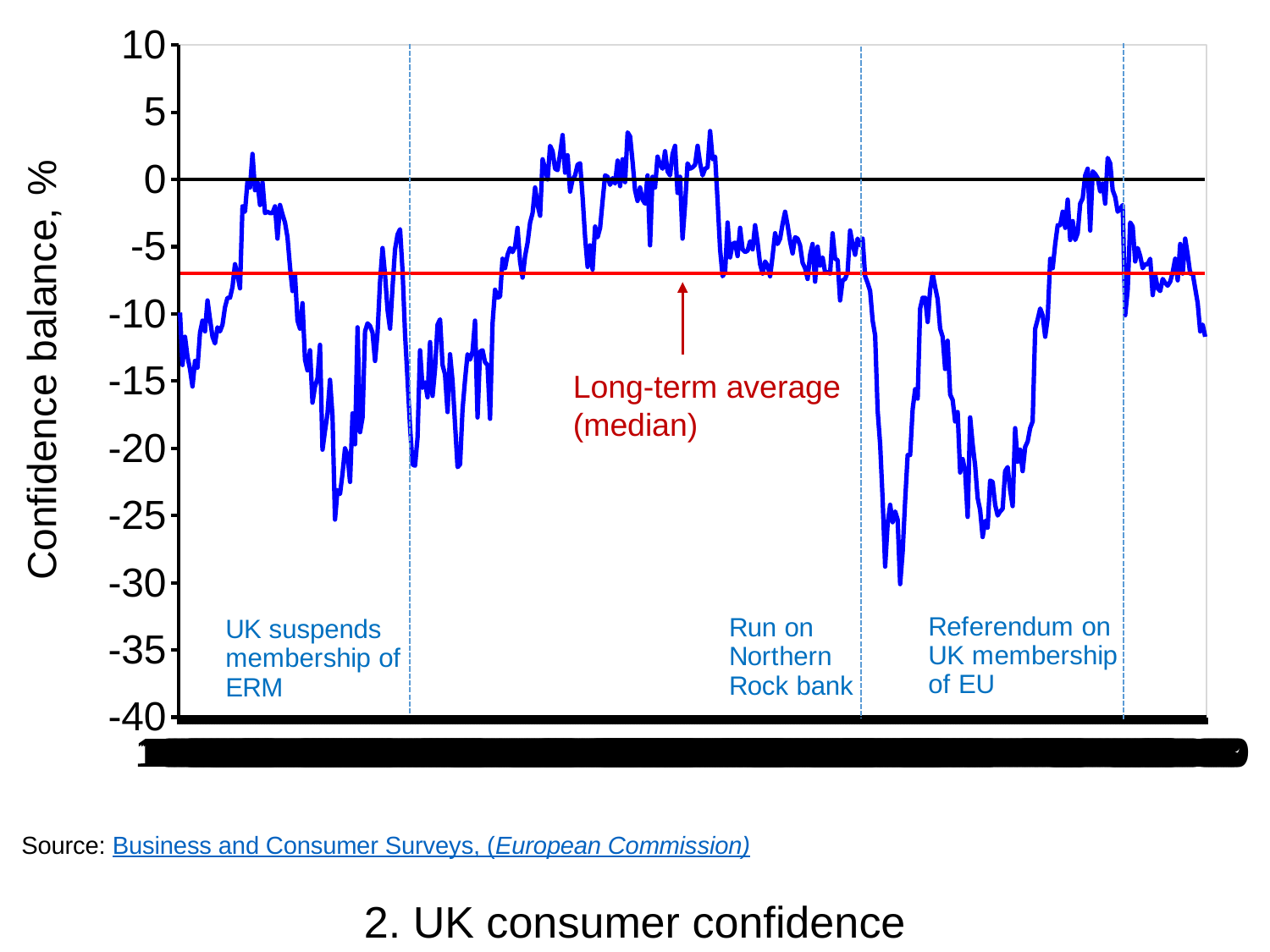
Is the highest point of the confidence balance line greater or less than 5? less What does the red horizontal line on the chart represent? Long-term average (median) Is the highest point of the confidence balance line greater or less than 0? greater What kind of chart is shown on the slide? Line chart Is the confidence balance at the 'UK suspends membership of ERM' dashed line greater or less than -10? less What is the label on the vertical axis of the chart? Confidence balance, % What is the highest value shown on the vertical axis of the chart? 10 How many vertical dashed event lines are marked on the chart? 3